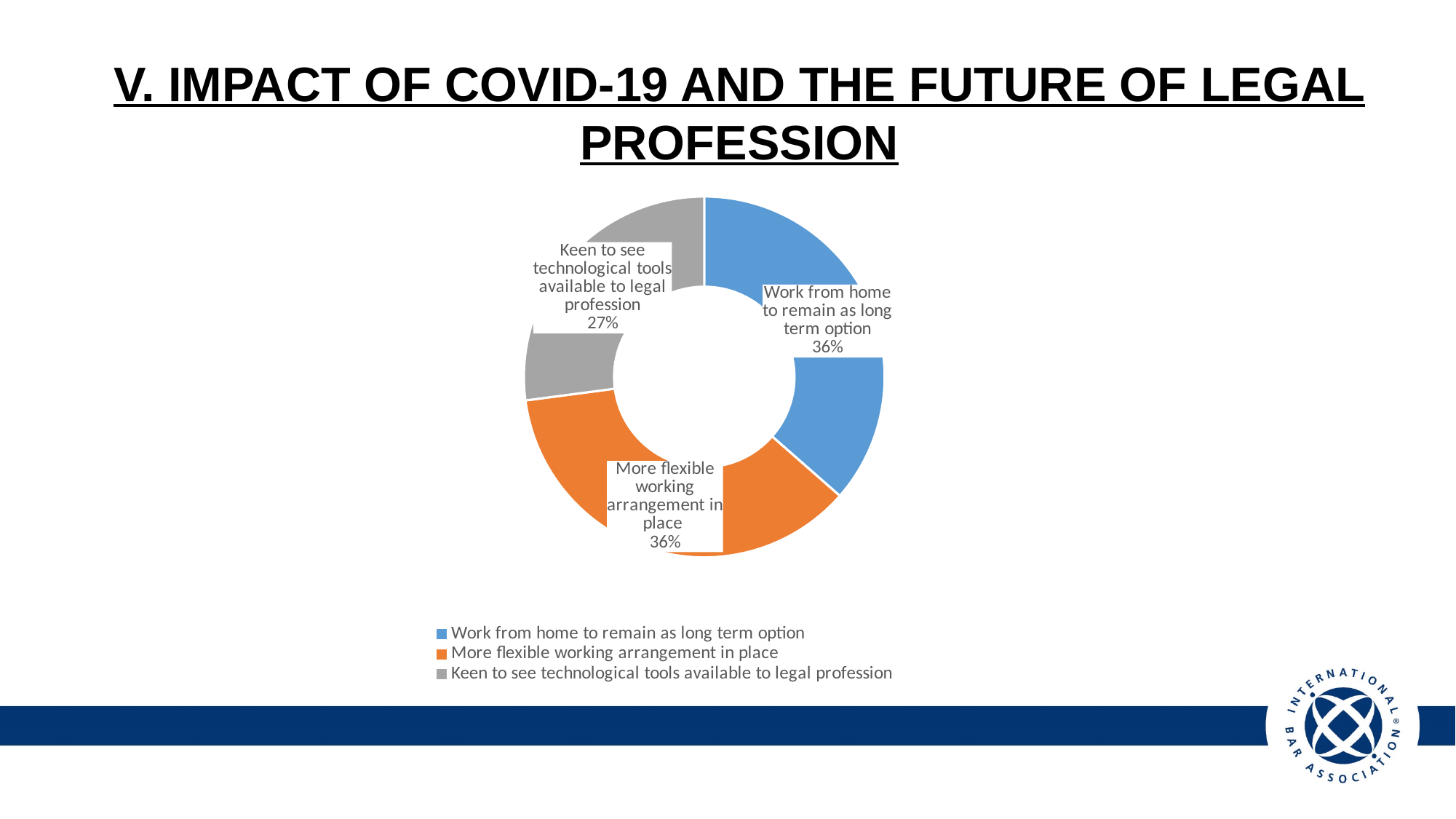
Which is larger: the share for 'Work from home to remain as long term option' or for 'Keen to see technological tools available to legal profession'? Work from home to remain as long term option Which category has the smallest share of the chart? Keen to see technological tools available to legal profession What colour is the slice for 'Keen to see technological tools available to legal profession'? Grey What kind of chart is shown on the slide? Doughnut (pie) chart What percentage is shown for 'Keen to see technological tools available to legal profession'? 27% What is the difference in percentage points between 'More flexible working arrangement in place' and 'Keen to see technological tools available to legal profession'? 9 percentage points What percentage is shown for 'More flexible working arrangement in place'? 36% How many categories are shown in the chart? 3 How many entries does the legend list? 3 What colour is the slice for 'Work from home to remain as long term option'? Blue What percentage is shown for 'Work from home to remain as long term option'? 36% What share of the chart does the 'More flexible working arrangement in place' slice represent? 36%